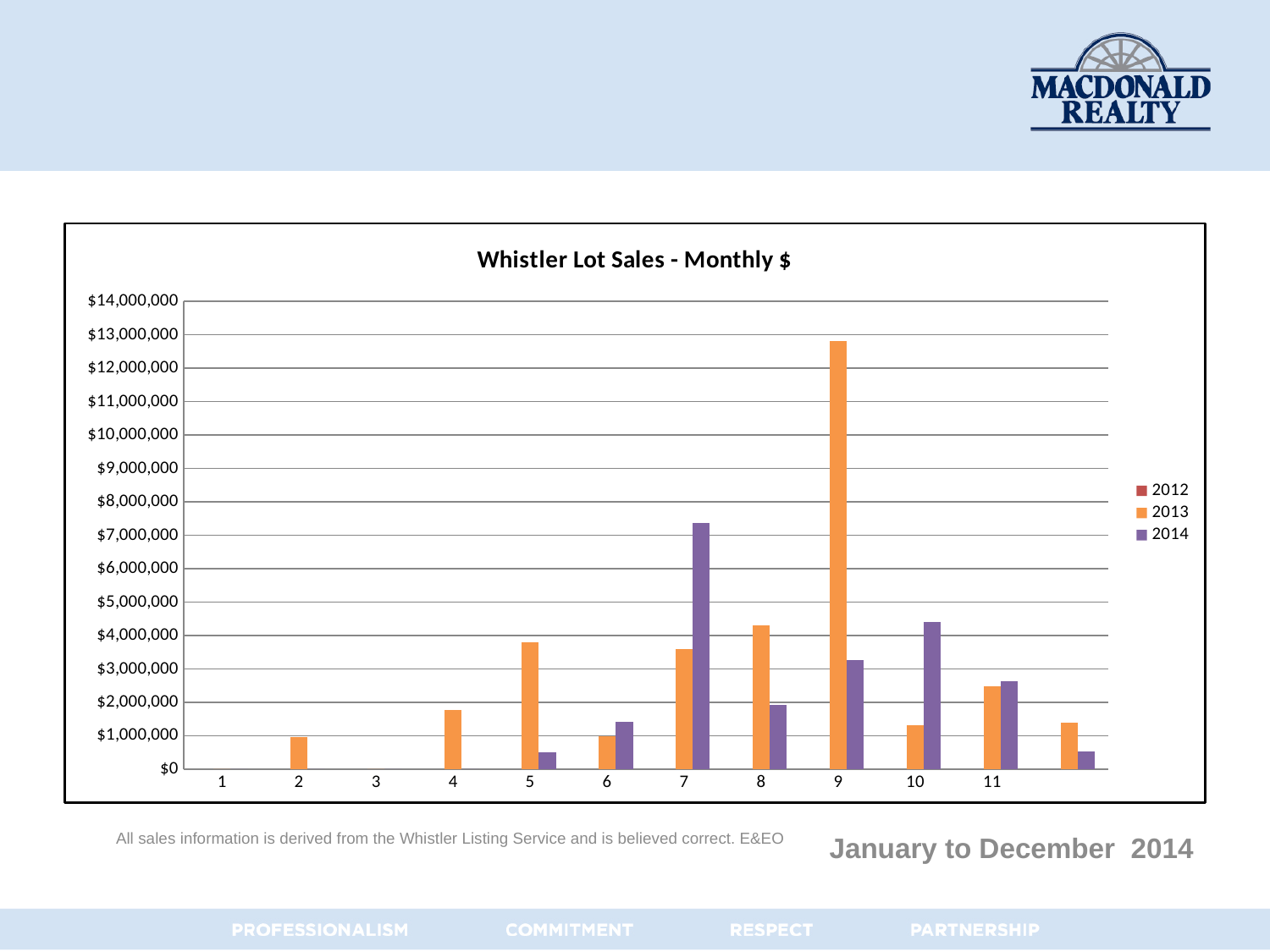
In which month does the 2014 series reach its highest value? 7 Which colour represents the 2014 series in the legend? purple Is the 2013 value for month 5 greater or less than $4,000,000? less In which month does the 2013 series reach its highest value? 9 In month 8, which series has the larger value, 2013 or 2014? 2013 In month 7, which series has the larger value, 2013 or 2014? 2014 In month 10, which series has the larger value, 2013 or 2014? 2014 How many series does the legend list? 3 What kind of chart is shown on the slide? bar chart What is the title of the chart? Whistler Lot Sales - Monthly $ Is the 2013 value for month 9 greater or less than $12,000,000? greater Is the 2014 value for month 7 greater or less than $6,000,000? greater